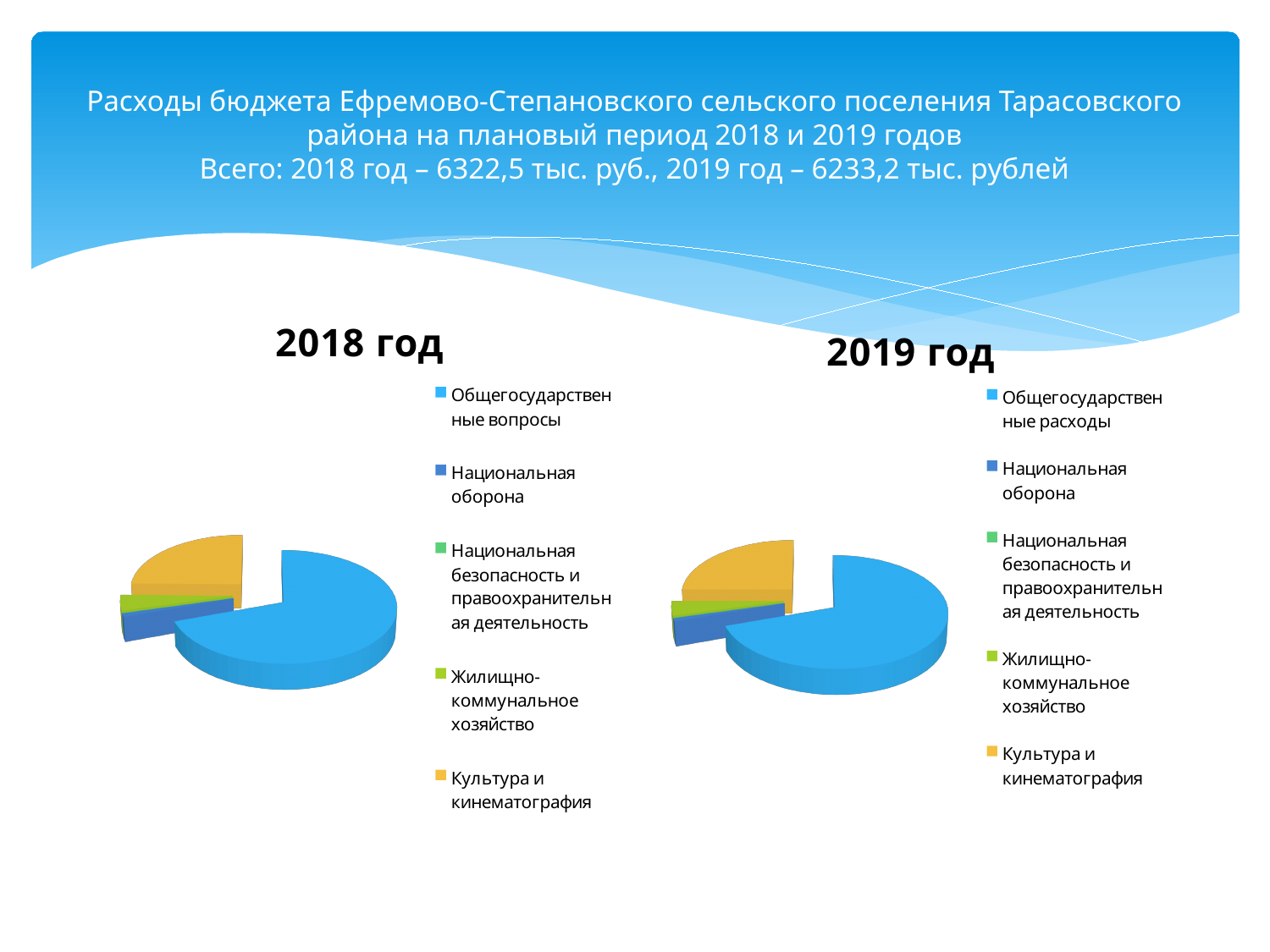
In the "2018 год" chart, which slice is larger: "Культура и кинематография" or "Национальная оборона"? Культура и кинематография In the "2018 год" chart, which legend entry is shown in yellow? Культура и кинематография In the "2019 год" chart, which category has the largest slice? Общегосударственные расходы In the "2018 год" chart, which category has the largest slice? Общегосударственные вопросы What kind of chart is the "2018 год" chart? pie chart In the "2019 год" chart, which slice is larger: "Общегосударственные расходы" or "Культура и кинематография"? Общегосударственные расходы According to the slide title, what is the total budget expenditure for 2019? 6233,2 тыс. рублей In the "2018 год" chart, how many categories does the legend list? 5 In the "2019 год" chart, how many categories does the legend list? 5 In the "2019 год" chart, which slice is larger: "Культура и кинематография" or "Жилищно-коммунальное хозяйство"? Культура и кинематография What kind of chart is the "2019 год" chart? pie chart